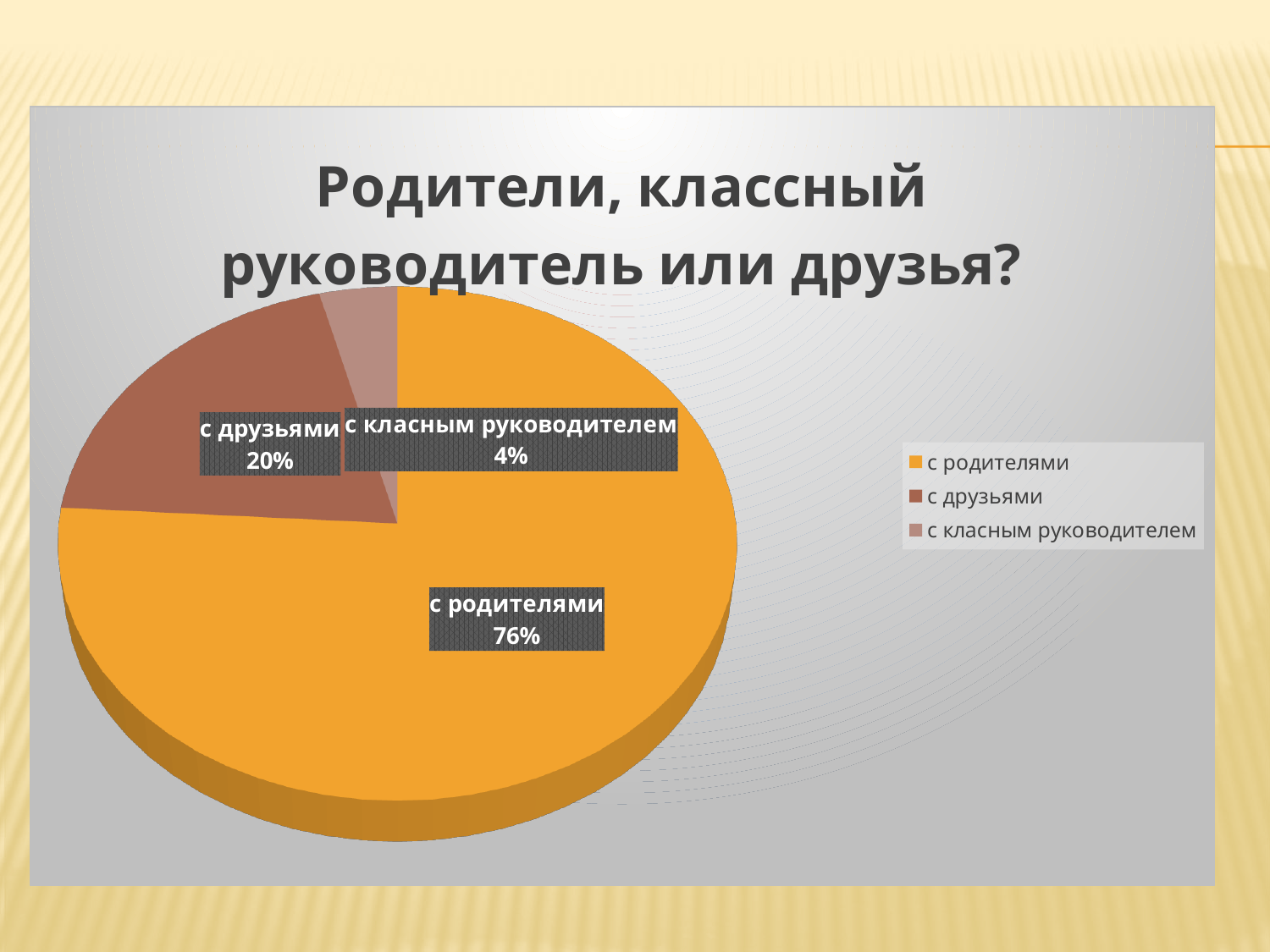
What share of the pie is labelled "с класным руководителем"? 4% What share of the pie is labelled "с друзьями"? 20% What is the difference in percentage points between "с родителями" and "с друзьями"? 56 What colour is the slice for "с родителями"? orange What kind of chart is shown on the slide? pie chart How many slices does the pie chart have? 3 Which category has the largest slice of the pie? с родителями What share of the pie is labelled "с родителями"? 76% How many entries does the legend list? 3 Which is larger, the share for "с друзьями" or the share for "с класным руководителем"? с друзьями What is the title of the chart? Родители, классный руководитель или друзья? Which category has the smallest slice of the pie? с класным руководителем